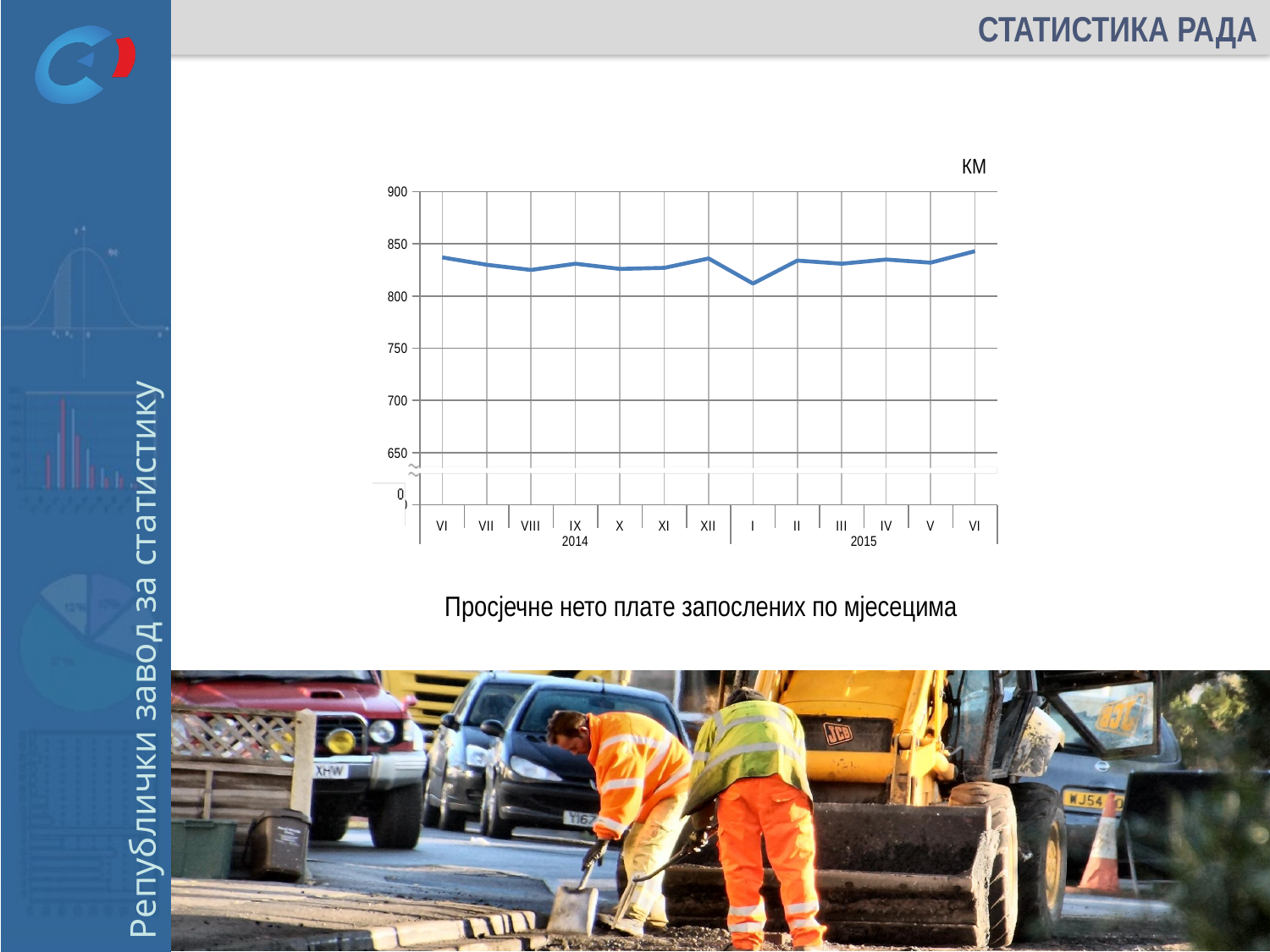
What kind of chart is shown on the slide? line chart Does the line rise or fall from XII 2014 to I 2015? fall Is the value for I 2015 greater or less than 800? greater Which month has the highest average net wage on the chart? VI 2015 Is the value for VI 2014 greater or less than 800? greater Is the value for VI 2015 greater or less than 850? less Which is larger, the value for I 2015 or the value for VI 2015? VI 2015 What is the title written below the chart? Просјечне нето плате запослених по мјесецима Which is larger, the value for XII 2014 or the value for I 2015? XII 2014 What unit is indicated above the chart's y axis? KM How many monthly data points are plotted on the chart? 13 Which month has the lowest average net wage on the chart? I 2015